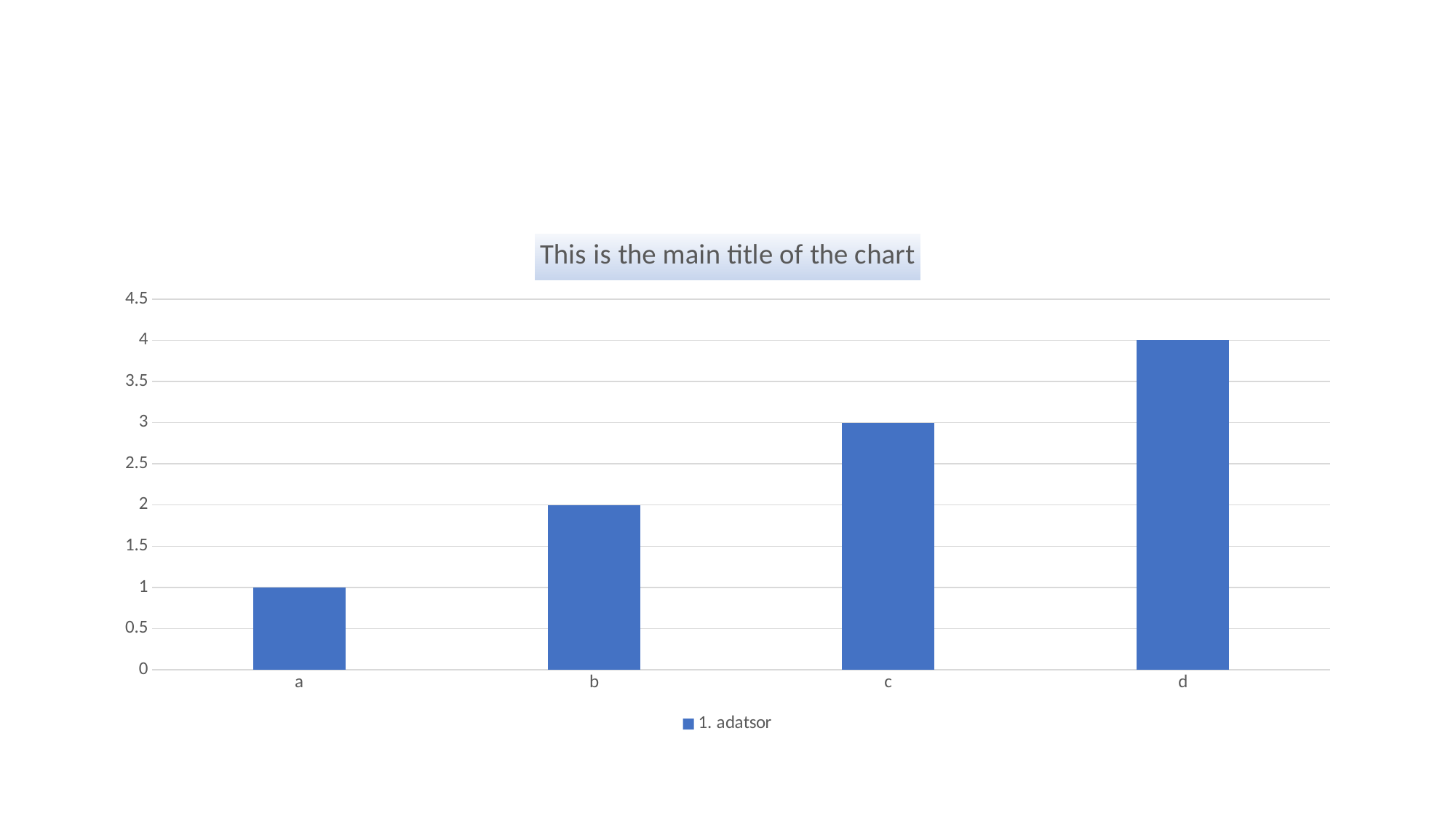
How many categories are shown on the x axis? 4 How many series does the legend list? 1 What is the value for category d? 4 What is the title of the chart? This is the main title of the chart Which category has the lowest value? a What is the difference between the values for d and b? 2 Which category has the highest value? d Do the values rise or fall from a to d? rise Is the value for c greater or less than 2.5? greater What kind of chart is shown? bar chart Which is larger, the value for c or the value for b? c What is the value for category a? 1